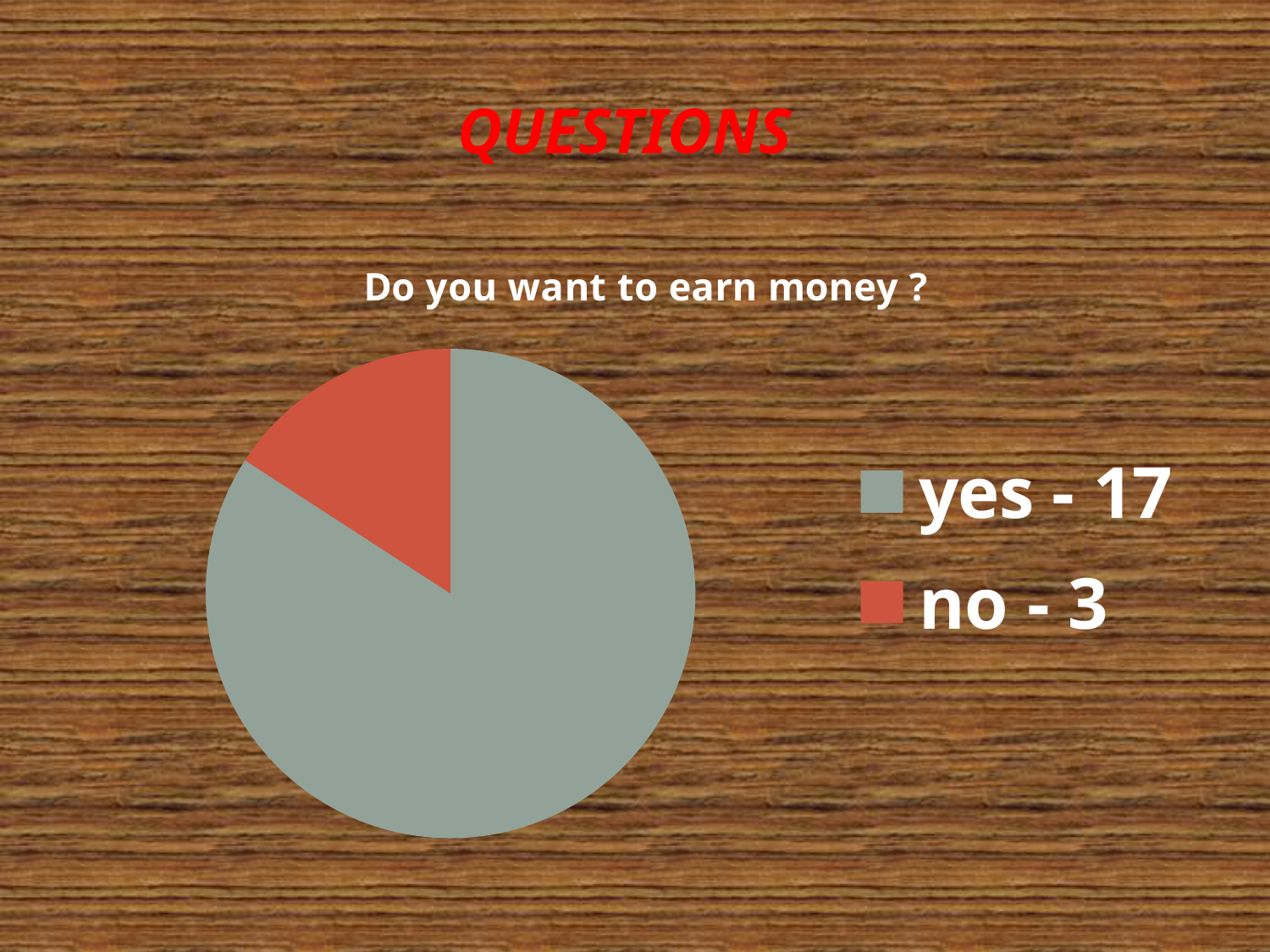
Which is larger, the value for "yes" or the value for "no"? yes What is the value for "no"? 3 What is the difference between the "yes" and "no" values? 14 How many entries does the legend list? 2 How many slices does the pie chart have? 2 What kind of chart is shown on the slide? pie chart What is the value for "yes"? 17 What is the total of all slices in the pie chart? 20 Which category has the largest slice? yes Which category has the smallest slice? no What is the title of the chart? Do you want to earn money ?